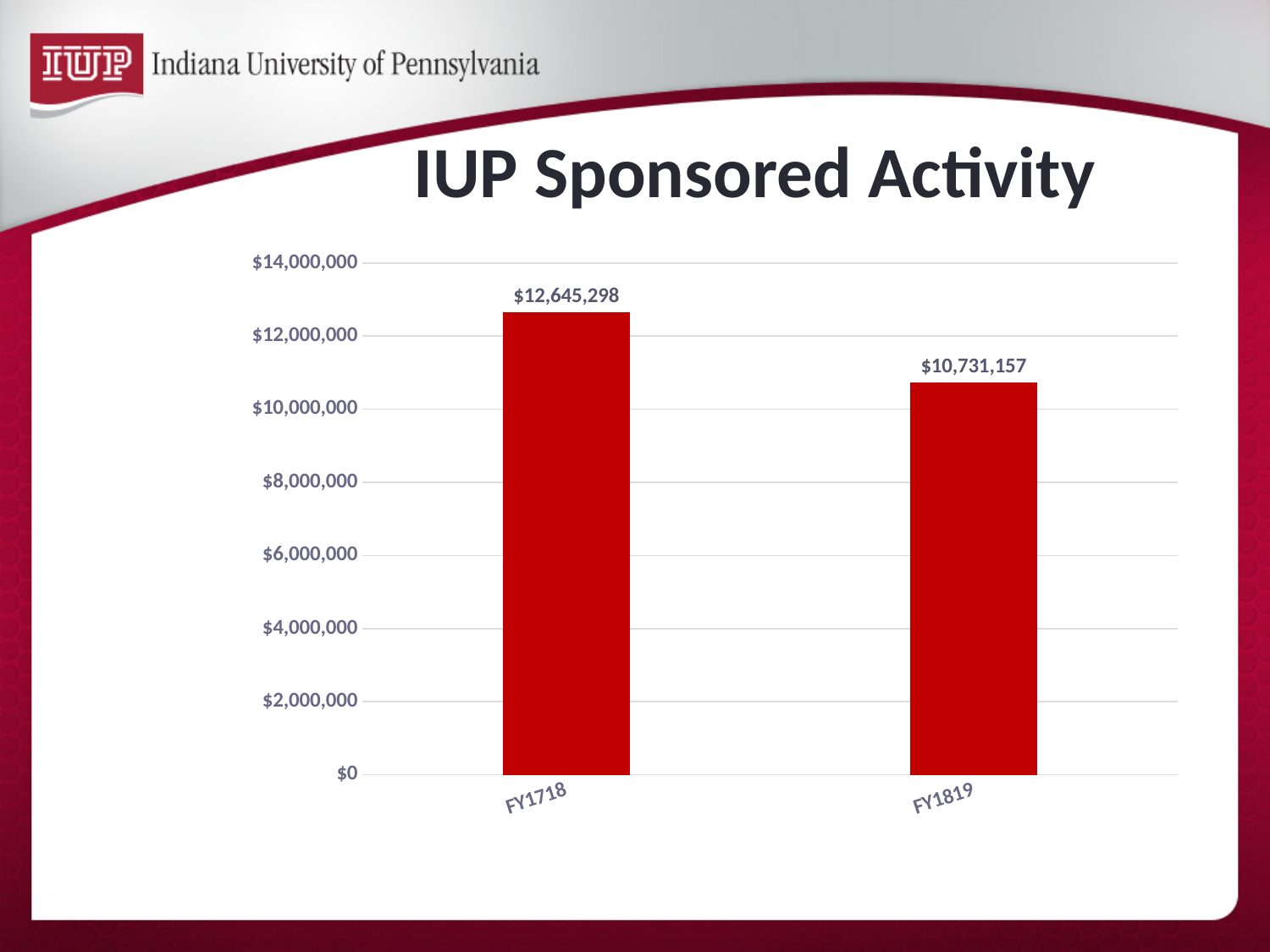
Which is larger, the value for FY1718 or FY1819? FY1718 What is the title of the chart? IUP Sponsored Activity Which fiscal year has the lowest value? FY1819 What is the difference between the FY1718 and FY1819 values? $1,914,141 What kind of chart is shown on the slide? bar chart Do the values rise or fall from FY1718 to FY1819? fall Is the value for FY1819 greater or less than $12,000,000? less What is the value for FY1819? $10,731,157 Is the value for FY1718 greater or less than $12,000,000? greater What is the value for FY1718? $12,645,298 How many fiscal years are shown on the chart? 2 Which fiscal year has the highest value? FY1718